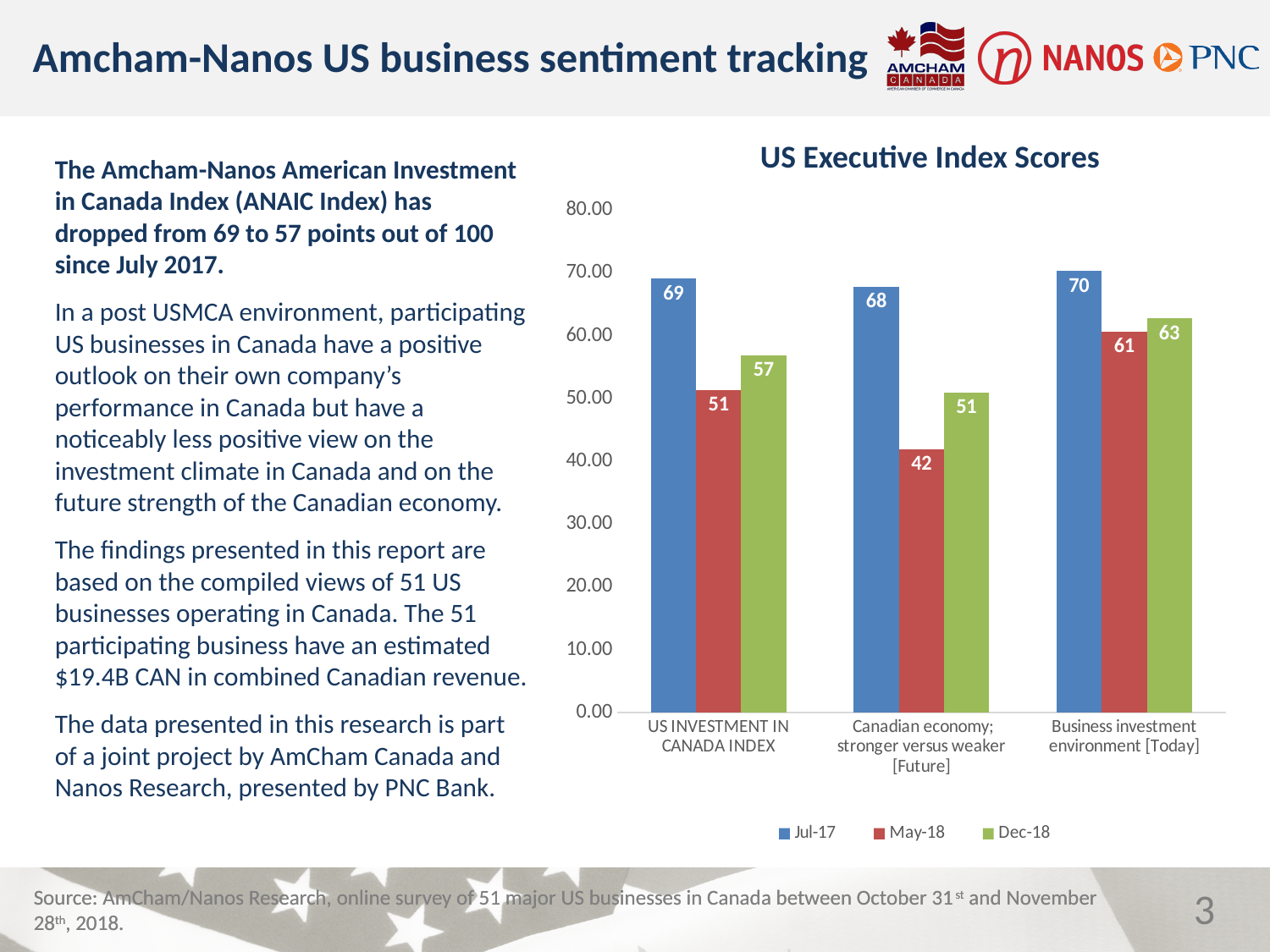
Which is larger for Business investment environment [Today]: the May-18 value or the Dec-18 value? Dec-18 What is the difference between the Jul-17 and Dec-18 values for US INVESTMENT IN CANADA INDEX? 12 What is the May-18 value for Business investment environment [Today]? 61 Is the May-18 value for Canadian economy; stronger versus weaker [Future] greater or less than 50.00? less What is the Dec-18 value for Canadian economy; stronger versus weaker [Future]? 51 How many categories are shown on the x axis? 3 What kind of chart is shown? bar chart What is the Jul-17 value for US INVESTMENT IN CANADA INDEX? 69 Which category has the lowest May-18 value? Canadian economy; stronger versus weaker [Future] How many series does the legend list? 3 What is the title of the chart? US Executive Index Scores Which category has the highest Jul-17 value? Business investment environment [Today]